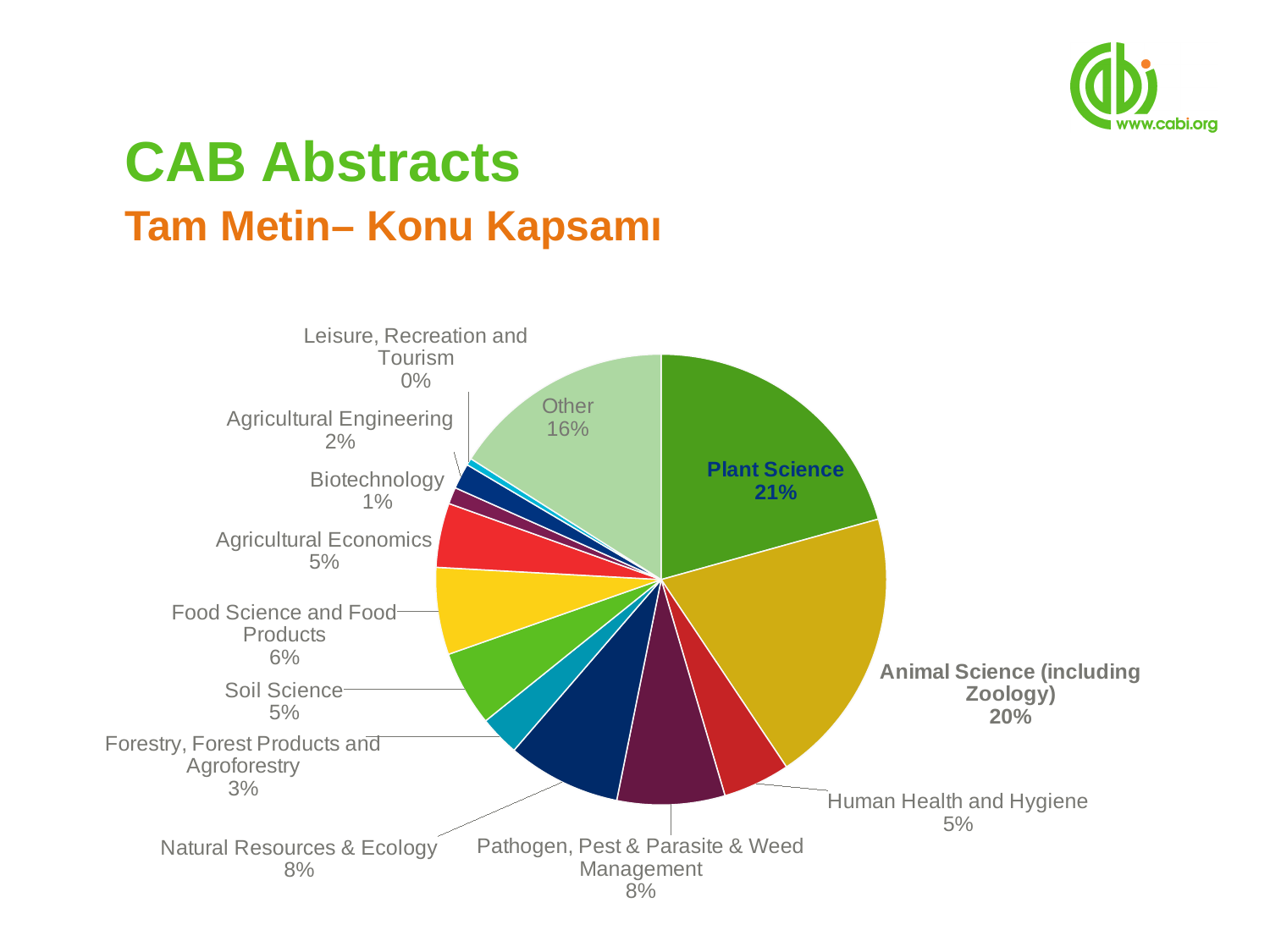
What is the value for Other? 16% What percentage is shown for Animal Science (including Zoology)? 20% Which is larger, Food Science and Food Products or Soil Science? Food Science and Food Products What percentage is shown for Forestry, Forest Products and Agroforestry? 3% What is the subtitle of the slide below 'CAB Abstracts'? Tam Metin– Konu Kapsamı What share of the pie does Plant Science have? 21% Which category has the largest share of the pie? Plant Science Which category has the smallest share of the pie? Leisure, Recreation and Tourism What is the combined share of Natural Resources & Ecology and Pathogen, Pest & Parasite & Weed Management? 16% What is the difference in percentage points between Plant Science and Animal Science (including Zoology)? 1 How many categories are shown in the pie chart? 13 What kind of chart is shown on the slide? Pie chart